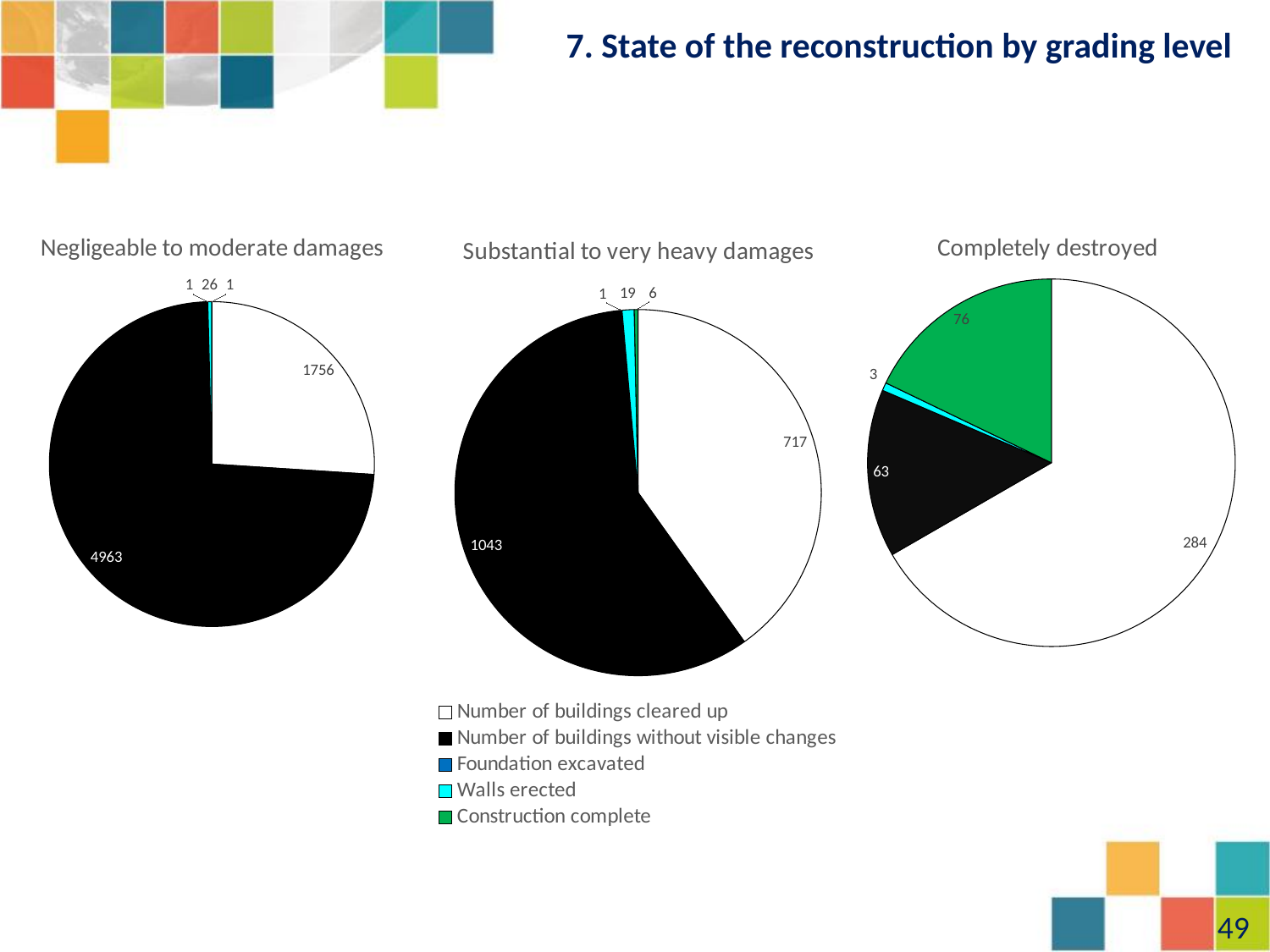
In the 'Completely destroyed' pie chart, what is the value for Number of buildings without visible changes? 63 In the 'Completely destroyed' pie chart, what is the value for Number of buildings cleared up? 284 In the 'Negligeable to moderate damages' pie chart, what is the value for Number of buildings without visible changes? 4963 In the 'Negligeable to moderate damages' pie chart, what is the difference between Number of buildings without visible changes and Number of buildings cleared up? 3207 In the 'Substantial to very heavy damages' pie chart, what is the value for Number of buildings without visible changes? 1043 What type of chart is used for 'Completely destroyed'? Pie chart How many entries does the shared legend list? 5 In the 'Negligeable to moderate damages' pie chart, what is the value for Number of buildings cleared up? 1756 In the 'Substantial to very heavy damages' pie chart, what is the value for Number of buildings cleared up? 717 In the 'Completely destroyed' pie chart, which category has the largest slice? Number of buildings cleared up In the 'Substantial to very heavy damages' pie chart, which is larger: Number of buildings cleared up or Number of buildings without visible changes? Number of buildings without visible changes In the 'Completely destroyed' pie chart, what is the value for Construction complete? 76